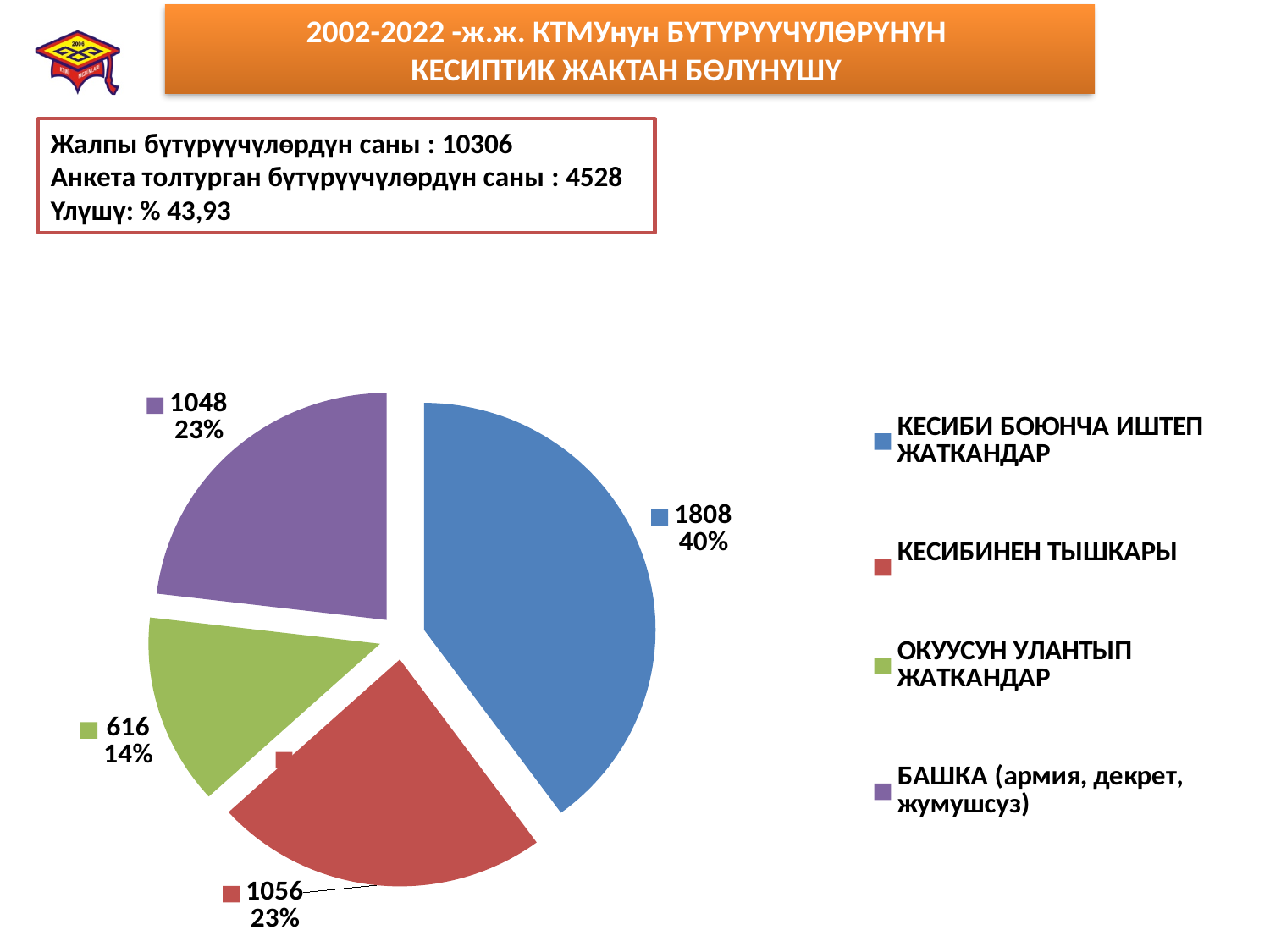
Which category has the smallest slice of the pie? ОКУУСУН УЛАНТЫП ЖАТКАНДАР What is the value for КЕСИБИ БОЮНЧА ИШТЕП ЖАТКАНДАР? 1808 Which category has the largest slice of the pie? КЕСИБИ БОЮНЧА ИШТЕП ЖАТКАНДАР What is the difference between the values for КЕСИБИ БОЮНЧА ИШТЕП ЖАТКАНДАР and ОКУУСУН УЛАНТЫП ЖАТКАНДАР? 1192 What share of the pie does КЕСИБИ БОЮНЧА ИШТЕП ЖАТКАНДАР represent? 40% How many slices does the pie chart have? 4 How many entries does the legend of the pie chart list? 4 What is the value for БАШКА (армия, декрет, жумушсуз)? 1048 What is the value for ОКУУСУН УЛАНТЫП ЖАТКАНДАР? 616 What is the value for КЕСИБИНЕН ТЫШКАРЫ? 1056 What kind of chart is shown on the slide? pie chart Which colour is used for the КЕСИБИНЕН ТЫШКАРЫ slice? red